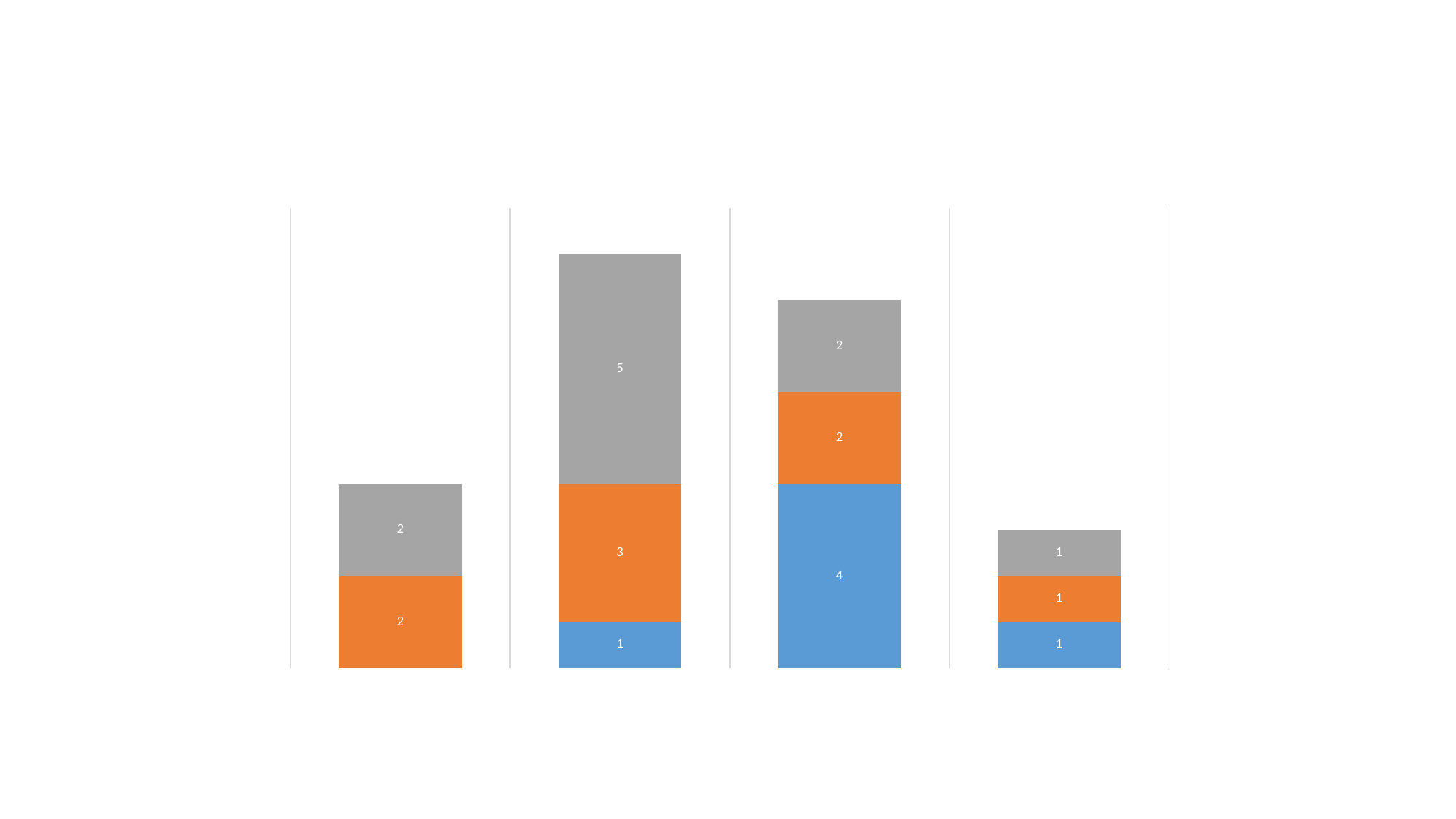
Which bar has the highest total? the second bar from the left What is the value of the orange segment in the second bar from the left? 3 What is the value of the blue segment in the third bar from the left? 4 What kind of chart is shown on the slide? stacked bar chart What is the value of the grey segment in the second bar from the left? 5 What is the total of the fourth bar from the left? 3 What is the value of the orange segment in the first bar from the left? 2 What is the total of the second bar from the left? 9 Which bar has the lowest total? the fourth bar from the left What is the total of the third bar from the left? 8 What is the difference between the grey segment of the second bar and the grey segment of the fourth bar? 4 How many bars are plotted in the chart? 4